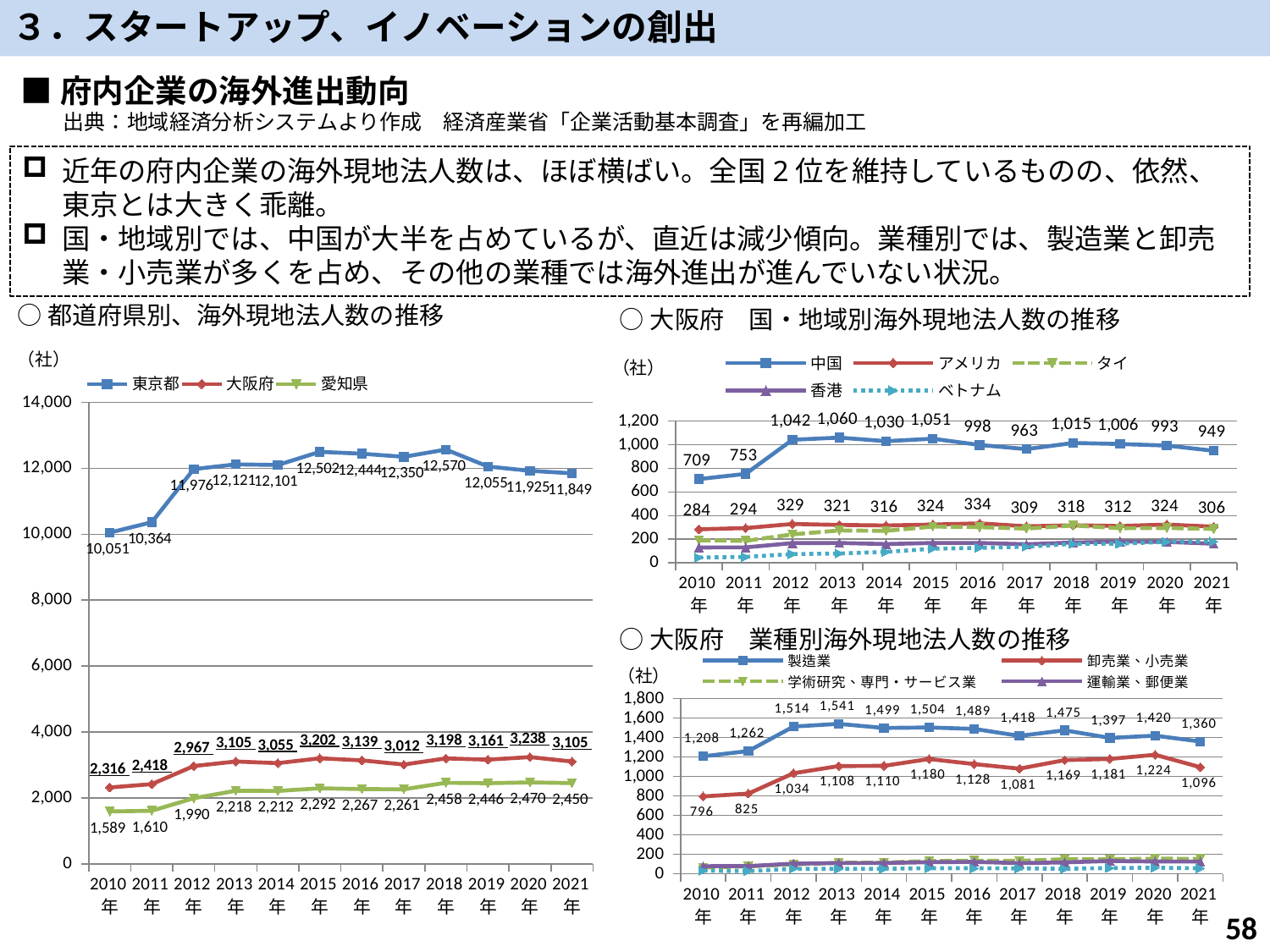
In the chart titled 大阪府 業種別海外現地法人数の推移, what is the value for 製造業 in 2013年? 1,541 In the chart titled 大阪府 業種別海外現地法人数の推移, which is larger in 2020年, 製造業 or 卸売業、小売業? 製造業 In the chart titled 都道府県別、海外現地法人数の推移, what is the difference between the 大阪府 and 愛知県 values in 2021年? 655 What kind of chart is the chart titled 大阪府 業種別海外現地法人数の推移? line chart In the chart titled 都道府県別、海外現地法人数の推移, in which year is the 東京都 value highest? 2018年 In the chart titled 大阪府 国・地域別海外現地法人数の推移, in which year is the アメリカ value highest? 2016年 In the chart titled 大阪府 国・地域別海外現地法人数の推移, what is the difference between the 中国 values in 2012年 and 2021年? 93 In the chart titled 都道府県別、海外現地法人数の推移, what is the value for 大阪府 in 2020年? 3,238 In the chart titled 大阪府 国・地域別海外現地法人数の推移, what is the value for 中国 in 2013年? 1,060 In the chart titled 都道府県別、海外現地法人数の推移, how many series does the legend list? 3 In the chart titled 大阪府 国・地域別海外現地法人数の推移, how many series does the legend list? 5 In the chart titled 都道府県別、海外現地法人数の推移, what is the value for 東京都 in 2018年? 12,570